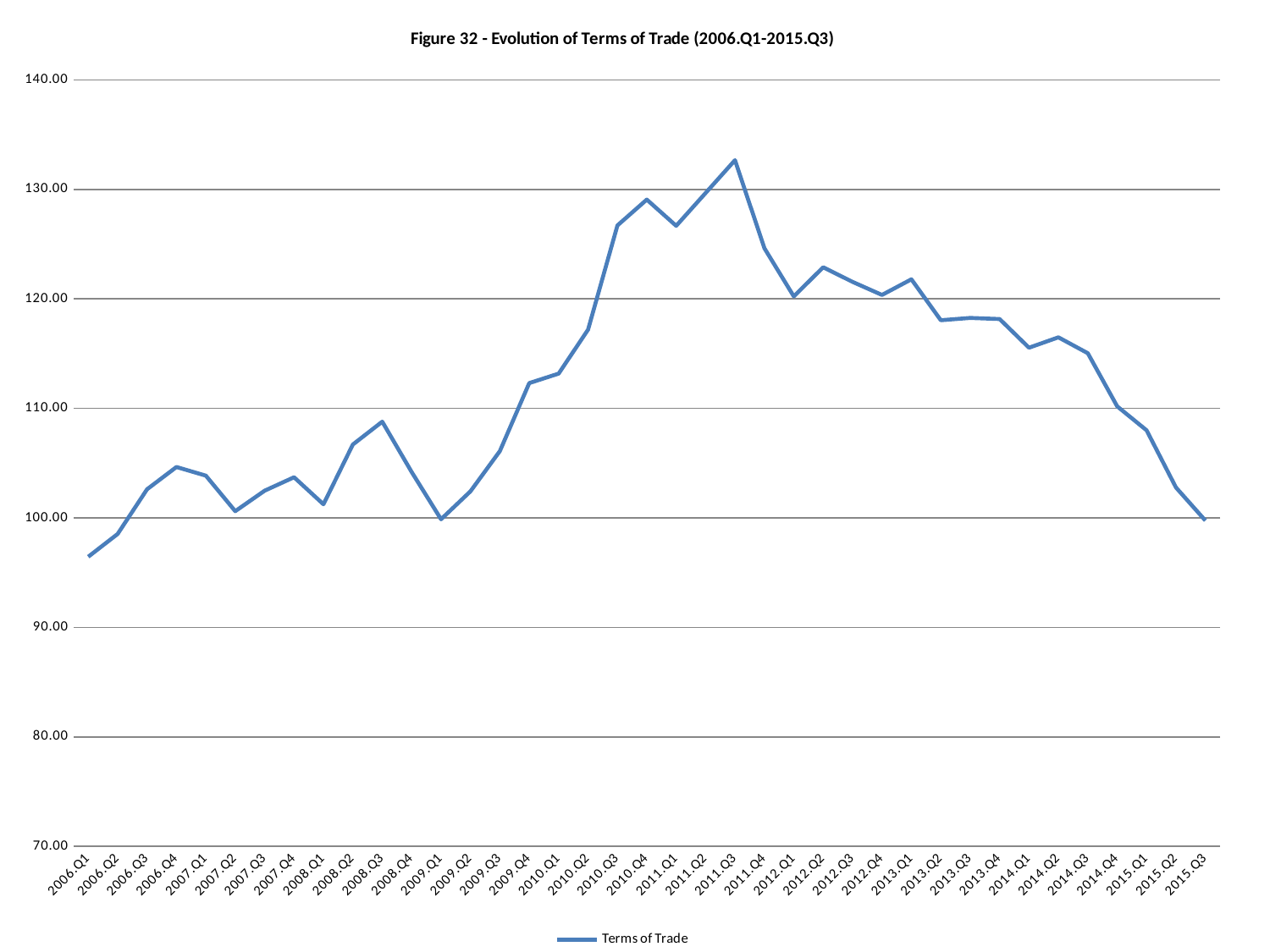
What is the title of the chart? Figure 32 - Evolution of Terms of Trade (2006.Q1-2015.Q3) What is the name of the series shown in the legend? Terms of Trade Is the value for 2011.Q3 greater or less than 130.00? greater What kind of chart is shown on the slide? Line chart Is the value for 2013.Q2 greater or less than 120.00? less In which quarter does Terms of Trade have its lowest value? 2006.Q1 Which is higher, the value for 2010.Q4 or the value for 2011.Q1? 2010.Q4 How many series does the legend list? 1 Does Terms of Trade generally rise or fall from 2011.Q3 to 2015.Q3? fall Is the value for 2006.Q1 greater or less than 100.00? less How many quarterly data points are plotted on the x axis? 39 In which quarter does Terms of Trade reach its highest value? 2011.Q3